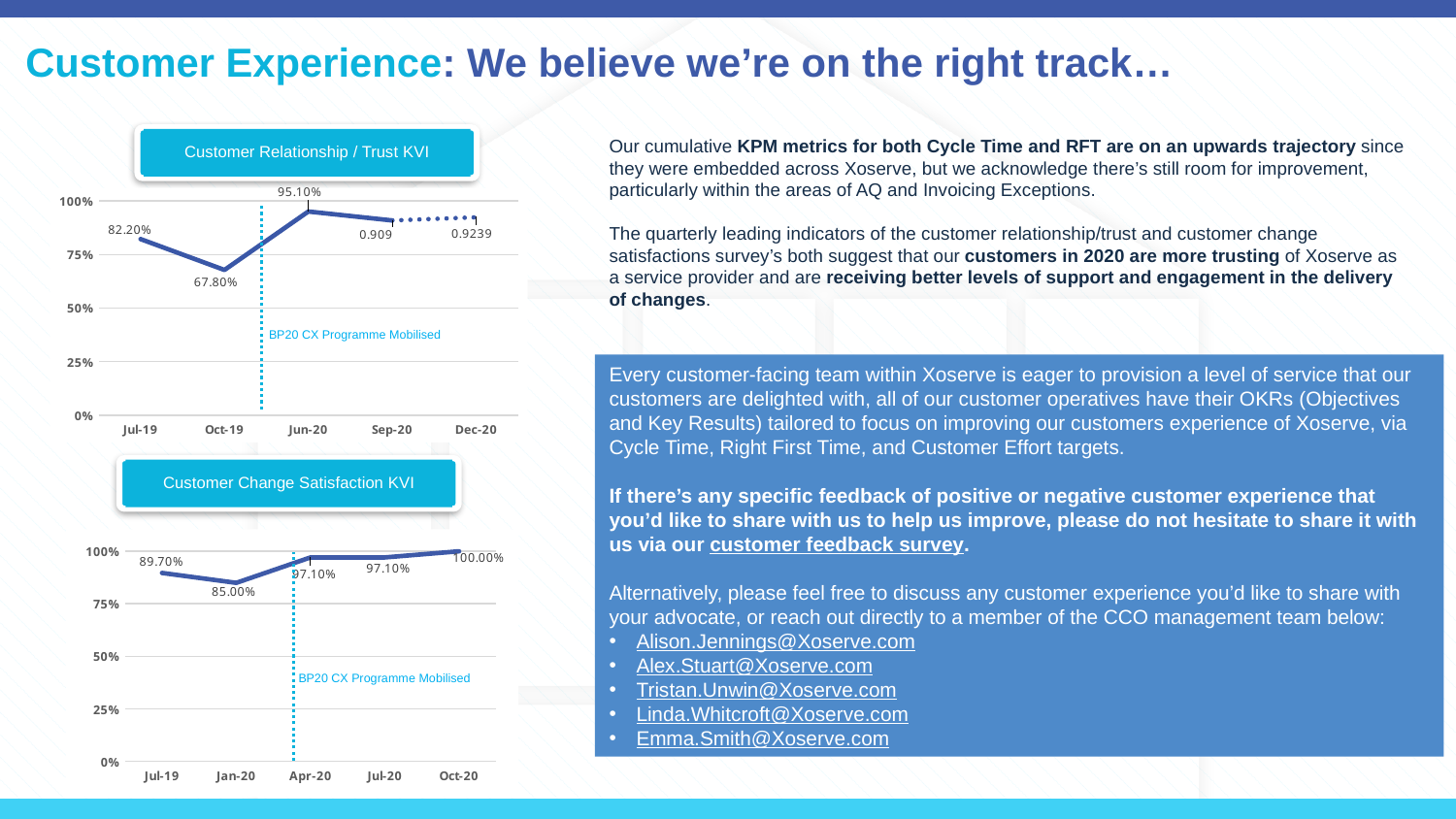
In the Customer Relationship / Trust KVI chart, what is the value for Jun-20? 95.10% In the Customer Relationship / Trust KVI chart, what is the value for Oct-19? 67.80% In the Customer Relationship / Trust KVI chart, what is the difference between the Jun-20 value and the Jul-19 value? 12.90% In the Customer Change Satisfaction KVI chart, what is the value for Oct-20? 100.00% In the Customer Change Satisfaction KVI chart, which is larger, the value for Jul-19 or the value for Jan-20? Jul-19 In the Customer Relationship / Trust KVI chart, what is the value labelled for Dec-20? 0.9239 In the Customer Relationship / Trust KVI chart, is the value for Oct-19 greater or less than 75%? less What type of chart is the Customer Change Satisfaction KVI chart? Line chart How many x-axis categories are shown in the Customer Relationship / Trust KVI chart? 5 In the Customer Change Satisfaction KVI chart, what is the value for Jan-20? 85.00% In the Customer Relationship / Trust KVI chart, which x-axis category has the lowest value? Oct-19 In the Customer Change Satisfaction KVI chart, which x-axis category has the highest value? Oct-20